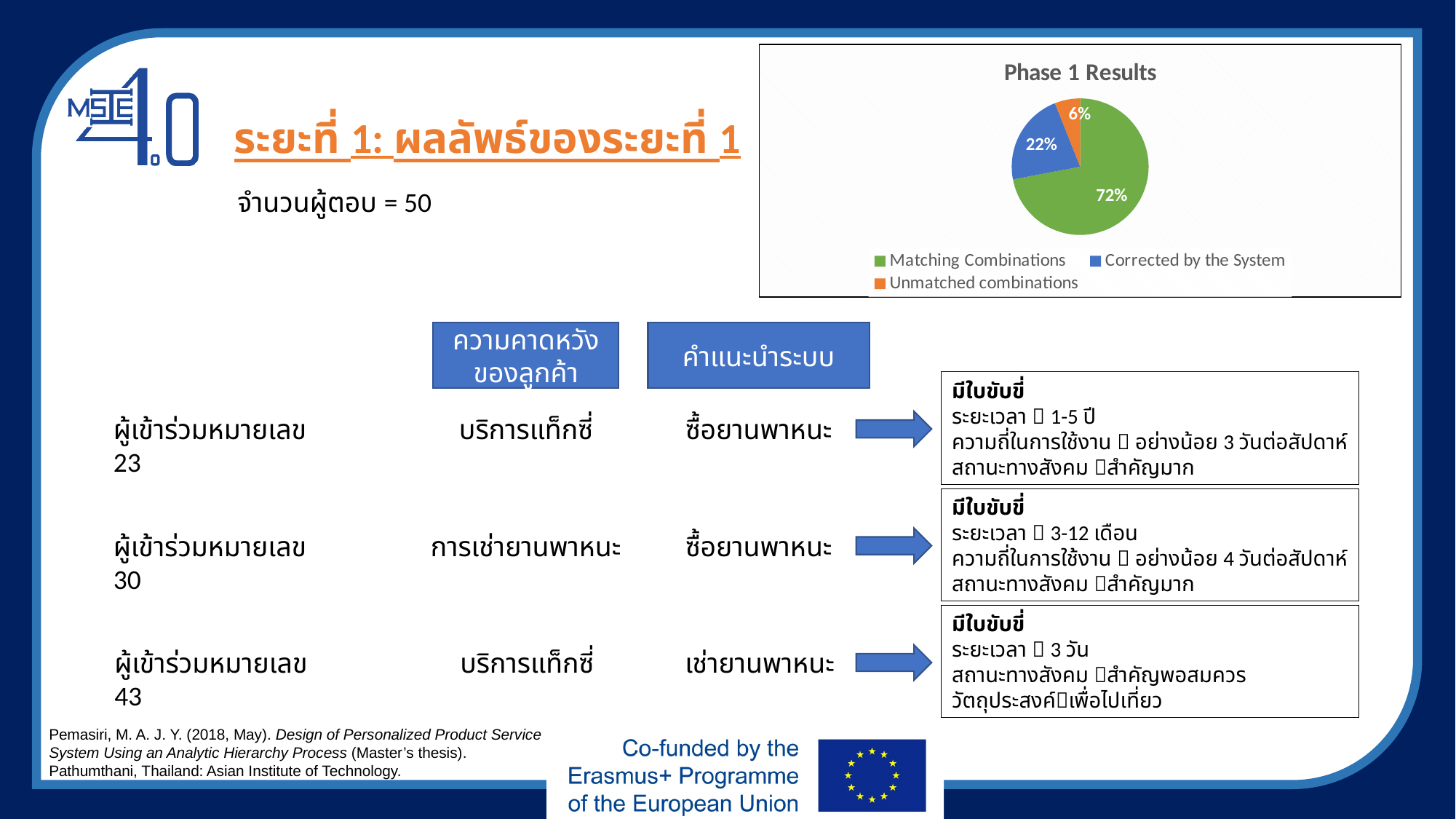
Which category has the smallest slice of the pie? Unmatched combinations What kind of chart is shown on the slide? pie chart What share of the pie is Matching Combinations? 72% What share of the pie is Unmatched combinations? 6% What is the difference in percentage points between Matching Combinations and Corrected by the System? 50 What share of the pie is Corrected by the System? 22% What is the combined share of Corrected by the System and Unmatched combinations? 28% Which is larger, Corrected by the System or Unmatched combinations? Corrected by the System What is the title of the chart on the slide? Phase 1 Results Which category has the largest slice of the pie? Matching Combinations How many categories does the pie chart show? 3 What colour is the Unmatched combinations slice? orange